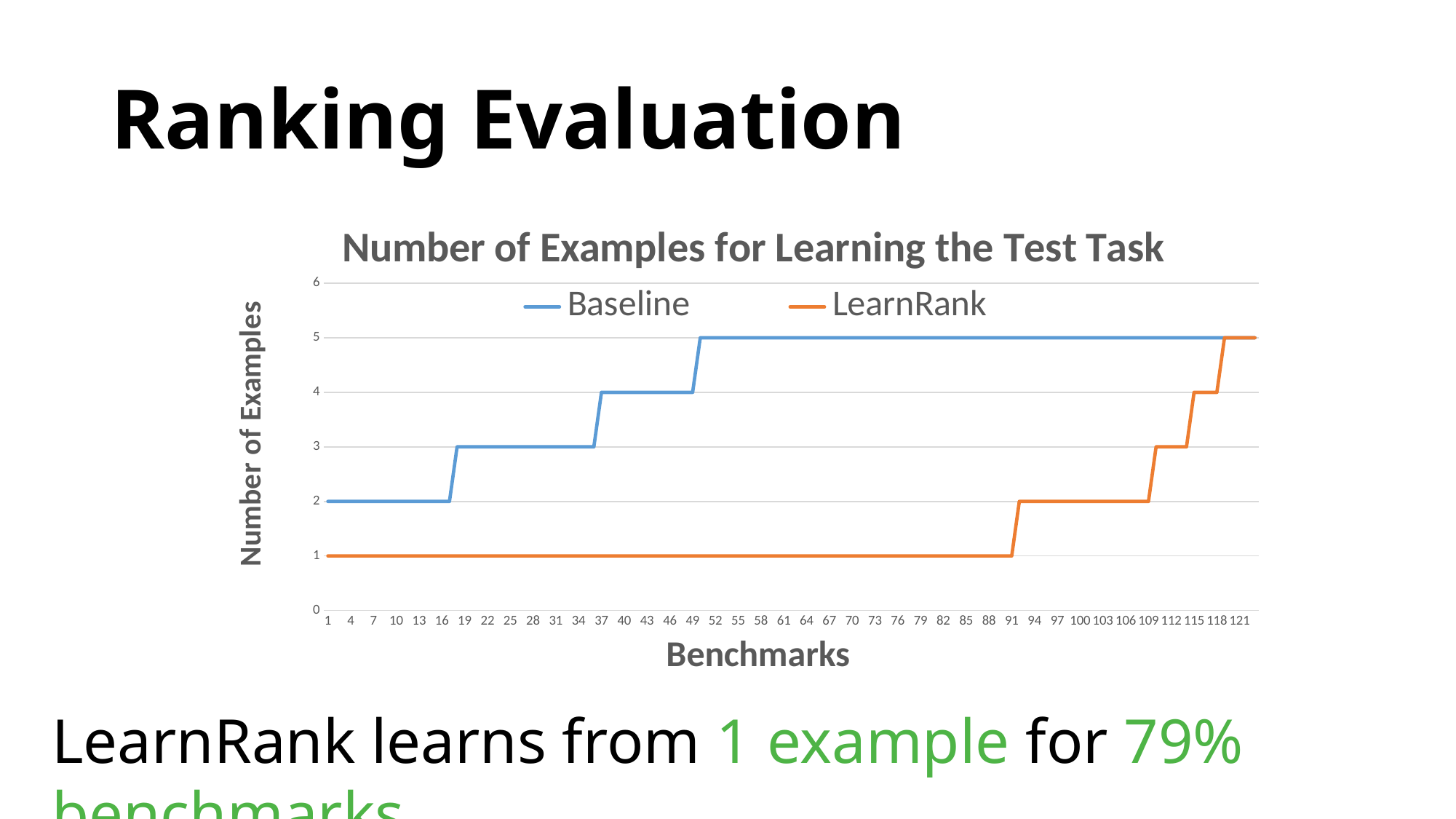
What is the Baseline value at benchmark 70? 5 At benchmark 40, which series has the higher value, Baseline or LearnRank? Baseline What is the LearnRank value at benchmark 1? 1 What is the Baseline value at benchmark 1? 2 What is the highest value reached by the Baseline series? 5 What is the difference between the Baseline and LearnRank values at benchmark 70? 4 Do the LearnRank values rise or fall as the benchmark number increases along the x axis? rise What is the title of the chart? Number of Examples for Learning the Test Task What kind of chart is shown on the slide? line chart How many series does the legend list? 2 What is the LearnRank value at benchmark 100? 2 What are the two series named in the legend? Baseline and LearnRank